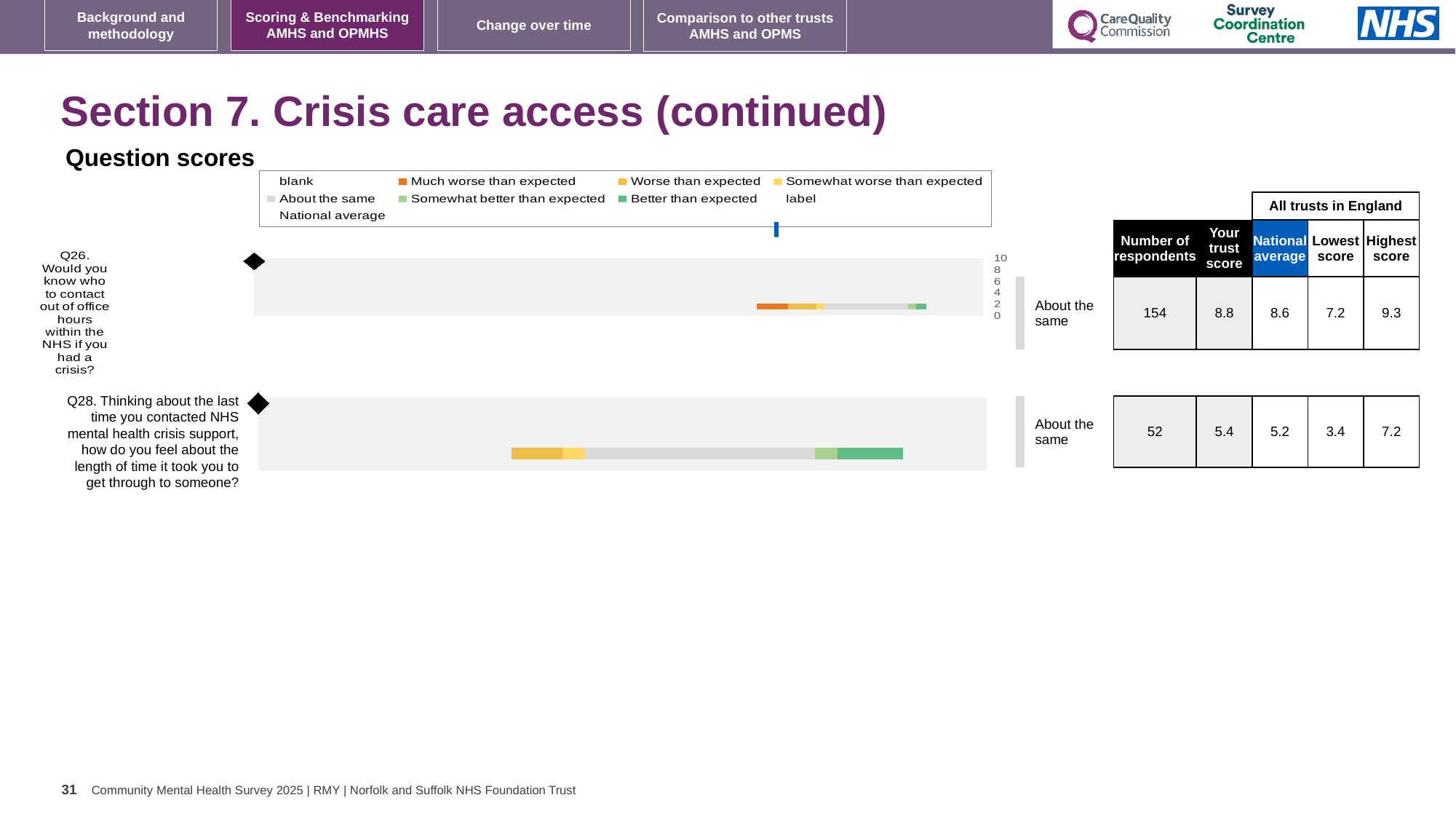
How many respondents answered Q28? 52 Which question had more respondents, Q26 or Q28? Q26 What benchmark category is shown next to the bar for Q28? About the same What kind of chart is used to show the question scores for Q26 and Q28? bar chart What is the difference between the highest score and the lowest score for Q28? 3.8 What benchmark category is shown next to the bar for Q26? About the same How many questions are plotted in the question scores chart? 2 In the chart legend, which colour represents 'Much worse than expected'? orange In the chart legend, which colour represents 'Better than expected'? green What is the national average score for Q28 (length of time to get through to crisis support)? 5.2 What is the trust score for Q26 (knowing who to contact out of office hours)? 8.8 For Q26, is the trust score higher or lower than the national average? higher